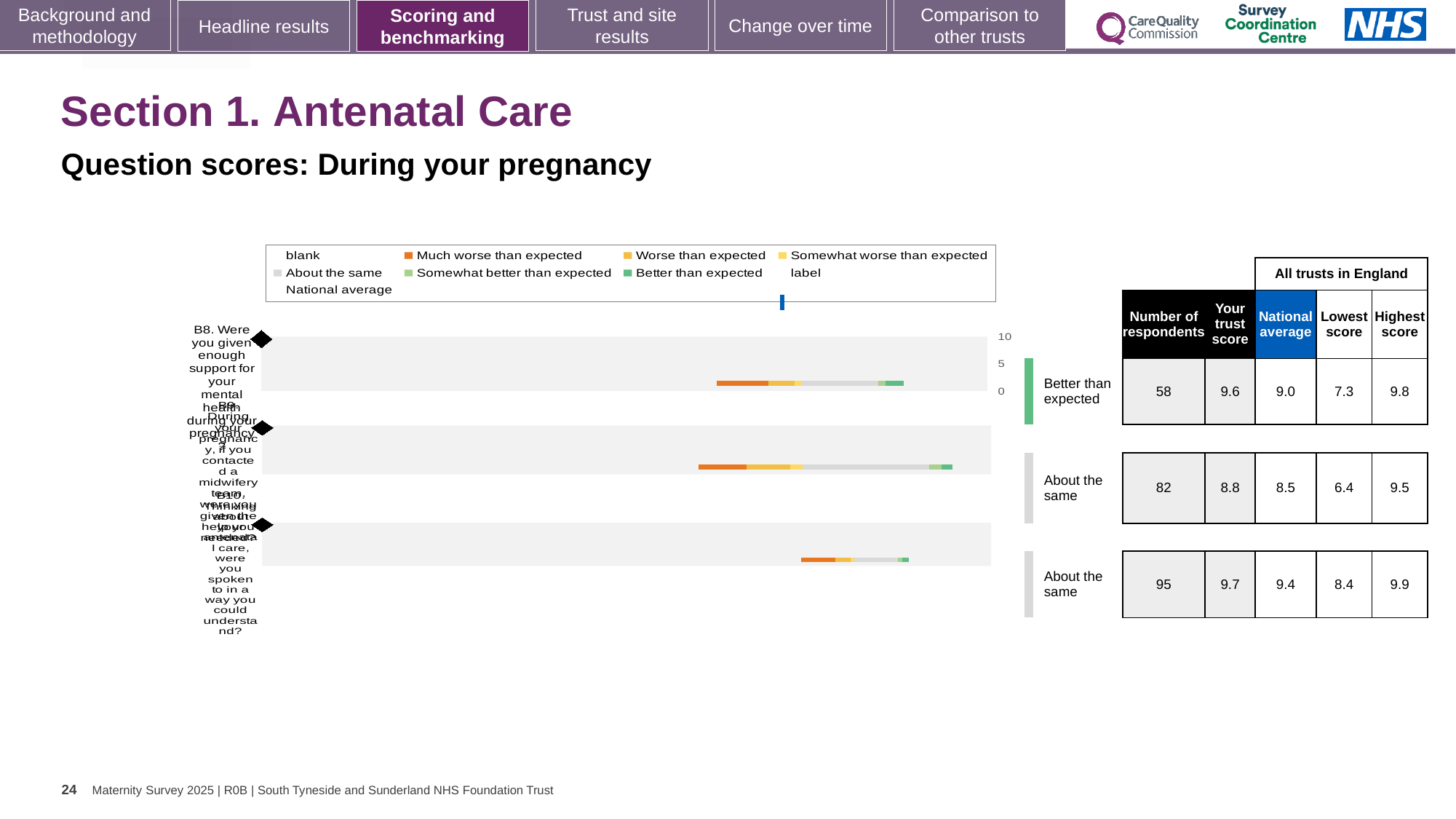
What benchmark category is shown for the top bar of the chart? Better than expected In the table beside the chart, what is the highest score for the bottom row? 9.9 In the table beside the chart, what is the trust score for the middle row? 8.8 In the chart legend, what colour represents 'Much worse than expected'? orange For the top row of the table beside the chart, what is the difference between the trust score and the national average? 0.6 For the top row of the table beside the chart, which is larger: the trust score or the national average? the trust score In the table beside the chart, what is the number of respondents for the top row? 58 What kind of chart is shown on the slide? bar chart Which row of the table beside the chart has the highest trust score? the bottom row (9.7) Which row of the table beside the chart has the lowest 'Lowest score' value? the middle row (6.4) In the table beside the chart, what is the national average for the bottom row? 9.4 How many question bars are plotted in the chart? 3